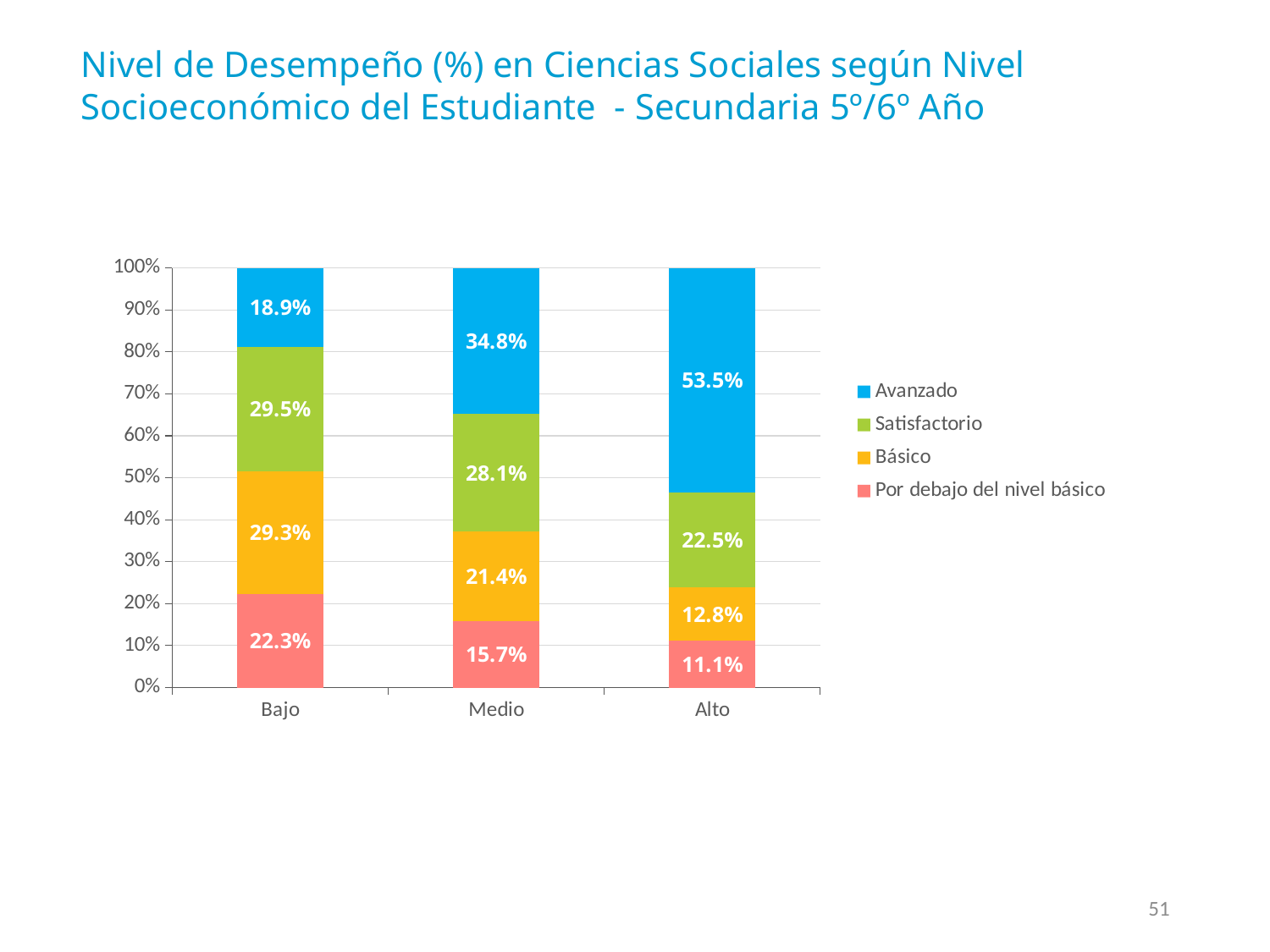
What is the Avanzado value for the Alto category? 53.5% What is the Satisfactorio value for the Alto category? 22.5% Which category has the highest Avanzado value? Alto What is the Básico value for the Medio category? 21.4% Which is larger: the Básico value for Bajo or the Básico value for Medio? Bajo What is the difference between the Avanzado values for Alto and Bajo? 34.6% Do the Avanzado values rise or fall from Bajo to Alto? Rise Which category has the lowest Por debajo del nivel básico value? Alto How many series does the legend list? 4 What is the Por debajo del nivel básico value for the Bajo category? 22.3% How many categories are shown on the x axis? 3 What kind of chart is shown on the slide? Stacked bar chart